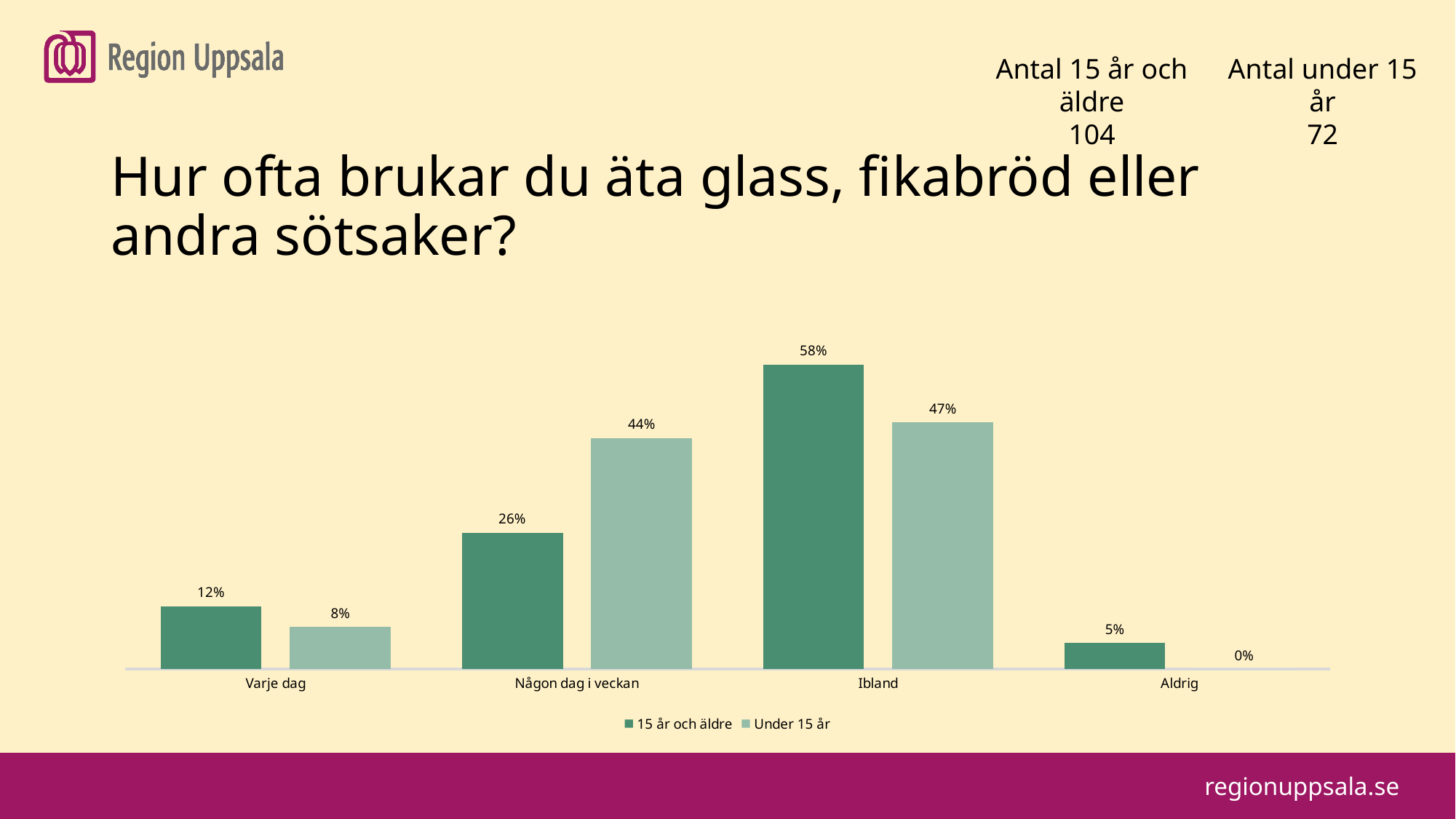
Which category has the lowest value for the "Under 15 år" series? Aldrig What kind of chart is shown on the slide? Bar chart In the "Varje dag" category, which series has the larger value? 15 år och äldre Which category has the highest value for the "15 år och äldre" series? Ibland What is the value for "Under 15 år" in the "Någon dag i veckan" category? 44% What is the difference between the "15 år och äldre" and "Under 15 år" values in the "Ibland" category? 11 percentage points How many categories are shown on the x axis? 4 How many series does the legend list? 2 What is the value for "15 år och äldre" in the "Ibland" category? 58% What are the two series listed in the legend? 15 år och äldre; Under 15 år What is the value for "Under 15 år" in the "Aldrig" category? 0% What is the difference between the "15 år och äldre" values for "Någon dag i veckan" and "Varje dag"? 14 percentage points